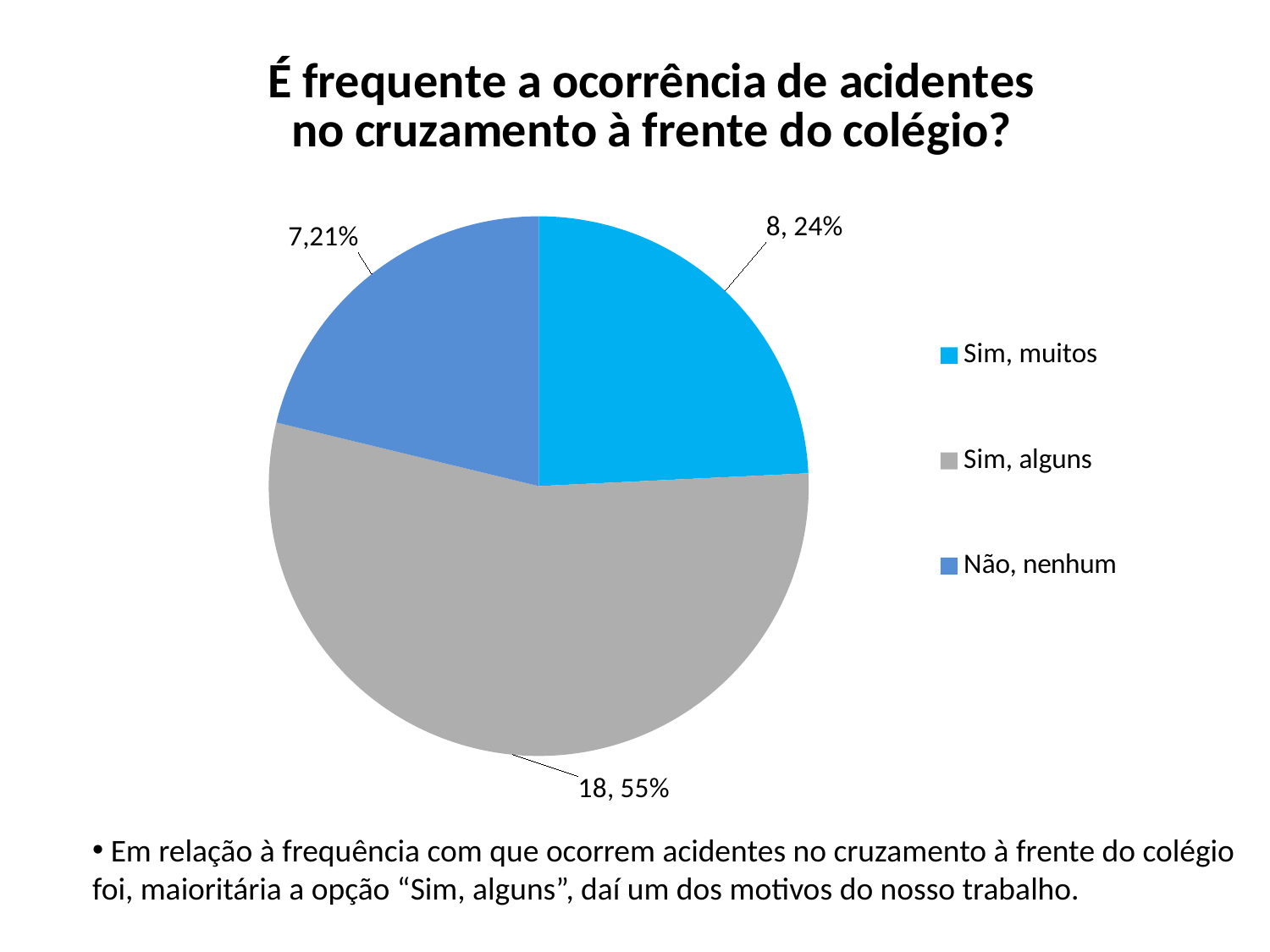
How many slices does the pie chart have? 3 Which category has the largest slice? Sim, alguns What is the difference in count between "Sim, alguns" and "Sim, muitos"? 10 What is the count for "Sim, alguns"? 18 What share of the pie does "Sim, alguns" represent? 55% What is the count for "Sim, muitos"? 8 What kind of chart is shown on the slide? pie chart What is the title of the chart? É frequente a ocorrência de acidentes no cruzamento à frente do colégio? What is the count for "Não, nenhum"? 7 What share of the pie does "Não, nenhum" represent? 21% How many entries does the legend list? 3 Which category has the smallest slice? Não, nenhum